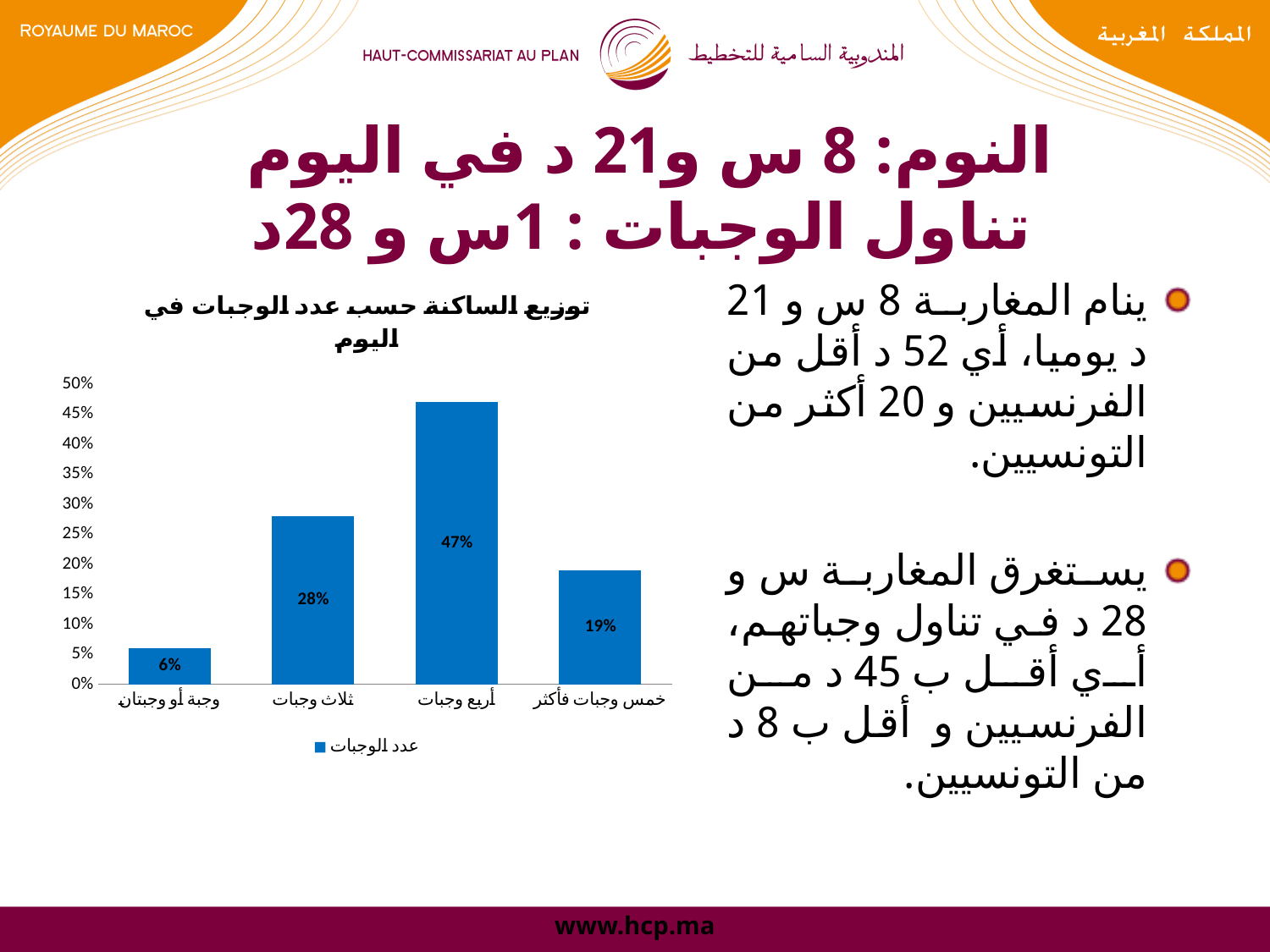
What is the difference between the values for أربع وجبات and ثلاث وجبات? 19% How many categories are shown on the x axis of the chart? 4 How many series does the chart legend list? 1 Which category has the highest value in the chart? أربع وجبات What is the value shown for the category وجبة أو وجبتان? 6% What type of chart is shown on the slide? Bar chart What is the value shown for the category خمس وجبات فأكثر? 19% Which category has the lowest value in the chart? وجبة أو وجبتان What is the value shown for the category ثلاث وجبات? 28% What is the legend entry shown below the chart? عدد الوجبات Which is larger, the value for ثلاث وجبات or the value for خمس وجبات فأكثر? ثلاث وجبات What percentage of the population has four meals (أربع وجبات) per day? 47%